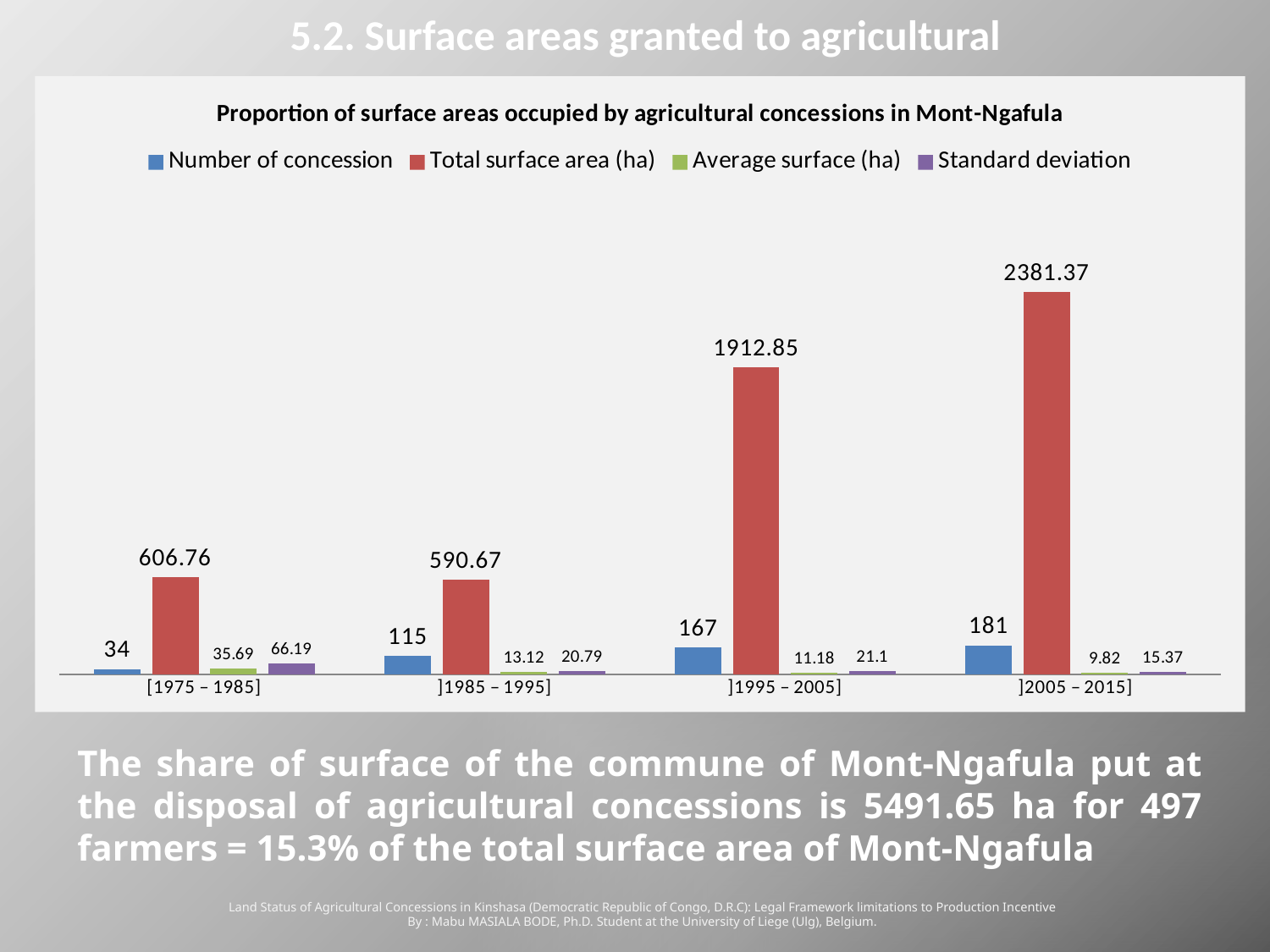
What is the Total surface area (ha) for the period ]2005 – 2015]? 2381.37 What is the Number of concession for the period [1975 – 1985]? 34 How many series does the legend list? 4 Which period has the highest Total surface area (ha)? ]2005 – 2015] Which is larger, the Total surface area (ha) for [1975 – 1985] or for ]1985 – 1995]? [1975 – 1985] What kind of chart is shown? Bar chart What is the Average surface (ha) for the period ]1985 – 1995]? 13.12 What is the difference in Number of concession between ]2005 – 2015] and ]1995 – 2005]? 14 Which period has the lowest Number of concession? [1975 – 1985] Does the Average surface (ha) rise or fall across the periods from [1975 – 1985] to ]2005 – 2015]? Fall What is the Standard deviation for the period ]1995 – 2005]? 21.1 How many periods are shown on the x axis? 4